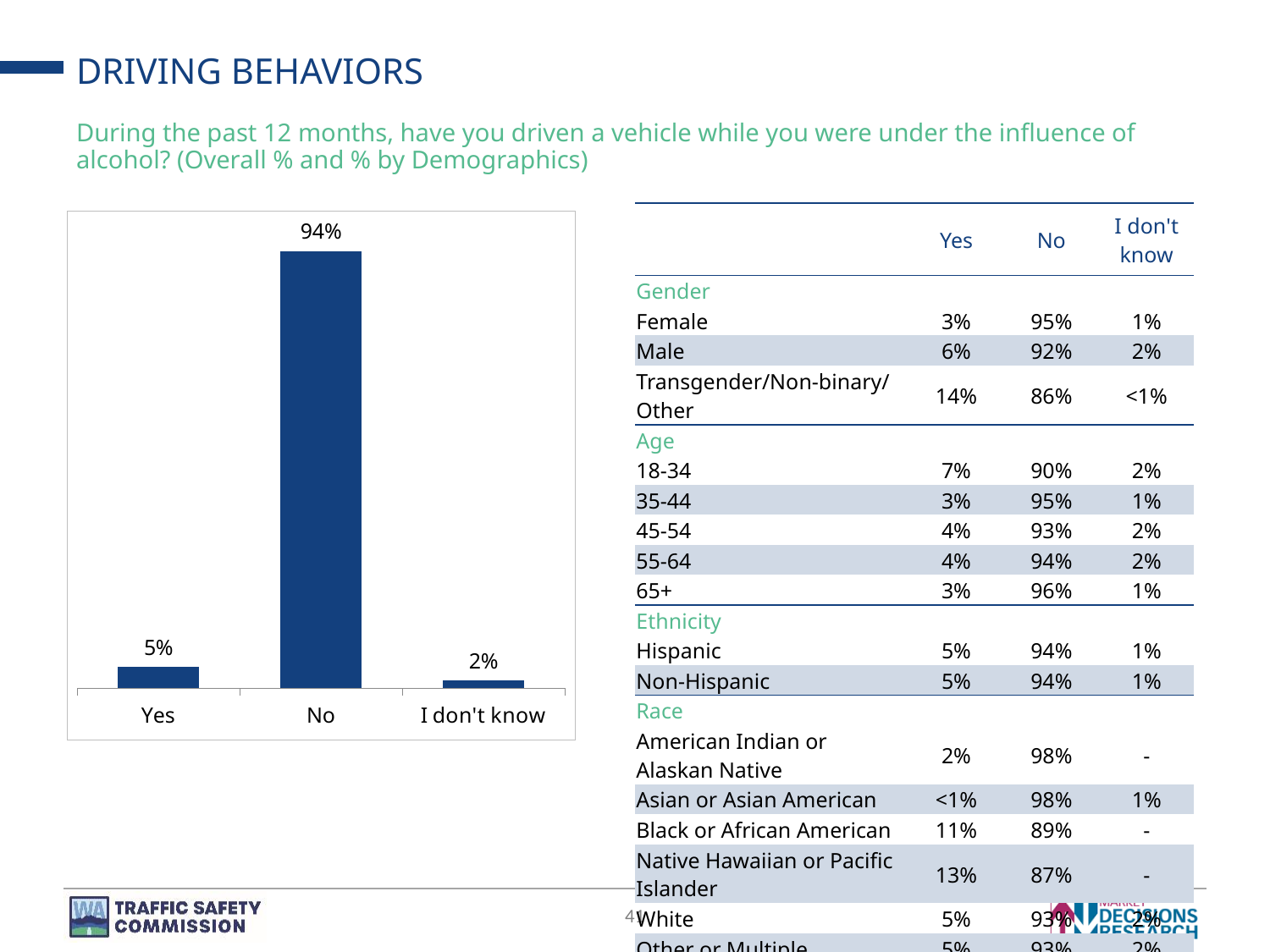
What type of chart is shown on the slide? Bar chart How many response categories are shown in the bar chart? 3 What percentage of respondents answered "I don't know" in the bar chart? 2% Which is larger in the bar chart, the value for "Yes" or the value for "I don't know"? Yes What is the difference between the "No" and "Yes" percentages in the bar chart? 89% What is the total of the three percentages shown in the bar chart? 101% What percentage of respondents answered "No" in the bar chart? 94% What is the difference between the "Yes" and "I don't know" percentages in the bar chart? 3% Which response category has the highest value in the bar chart? No What is the title of the slide containing the bar chart? DRIVING BEHAVIORS Which response category has the lowest value in the bar chart? I don't know What percentage of respondents answered "Yes" in the bar chart? 5%